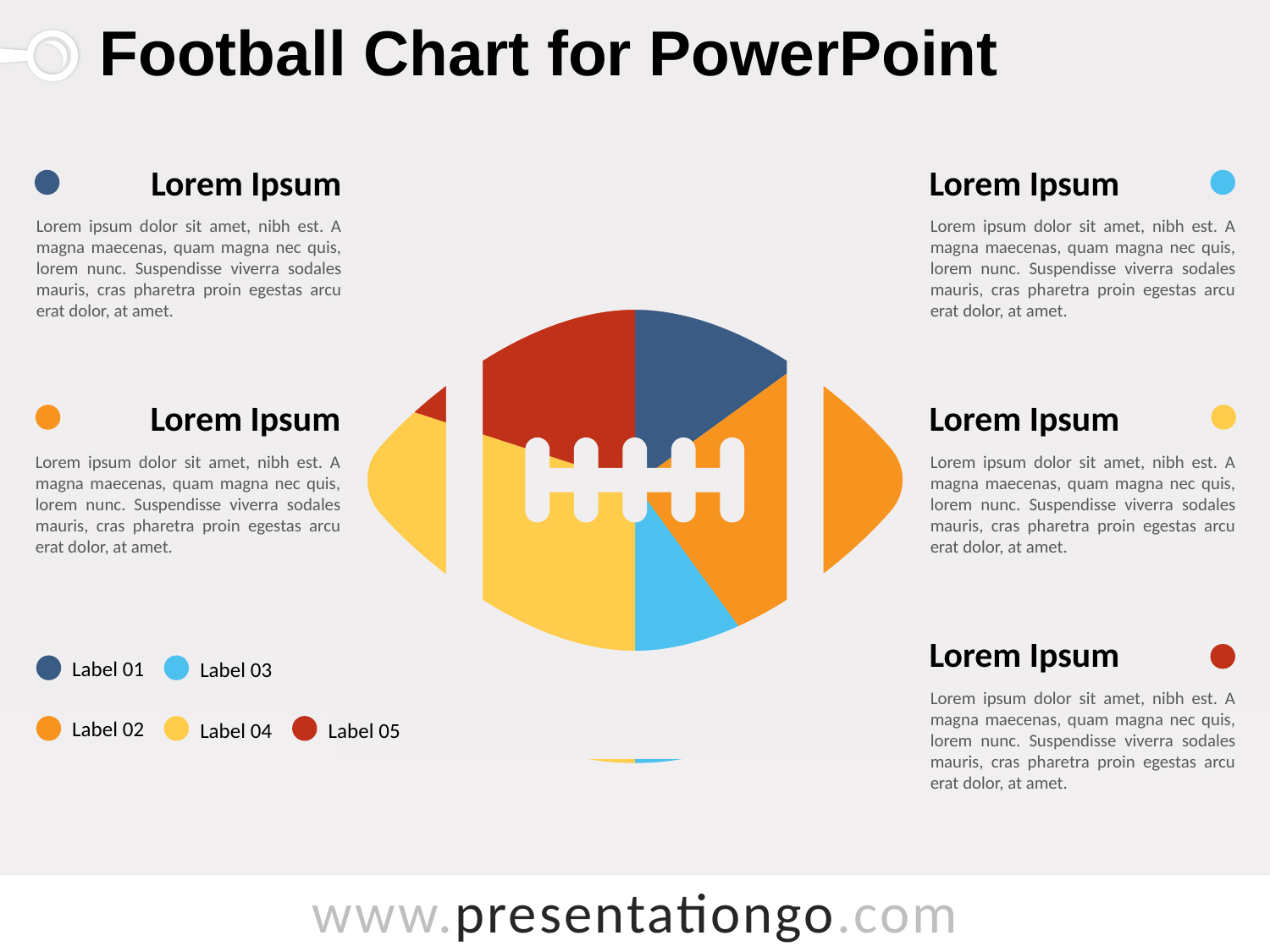
Which slice is larger, Label 01 or Label 04? Label 04 What is the title of the slide? Football Chart for PowerPoint Which legend entry has the smallest slice in the pie chart? Label 03 Which slice is larger, Label 03 or Label 04? Label 04 What kind of chart is shown on the slide? pie chart What colour represents Label 03 in the legend? light blue What colour represents Label 05 in the legend? red How many slices does the pie chart have? 5 Which slice is larger, Label 03 or Label 02? Label 02 How many entries does the chart legend list? 5